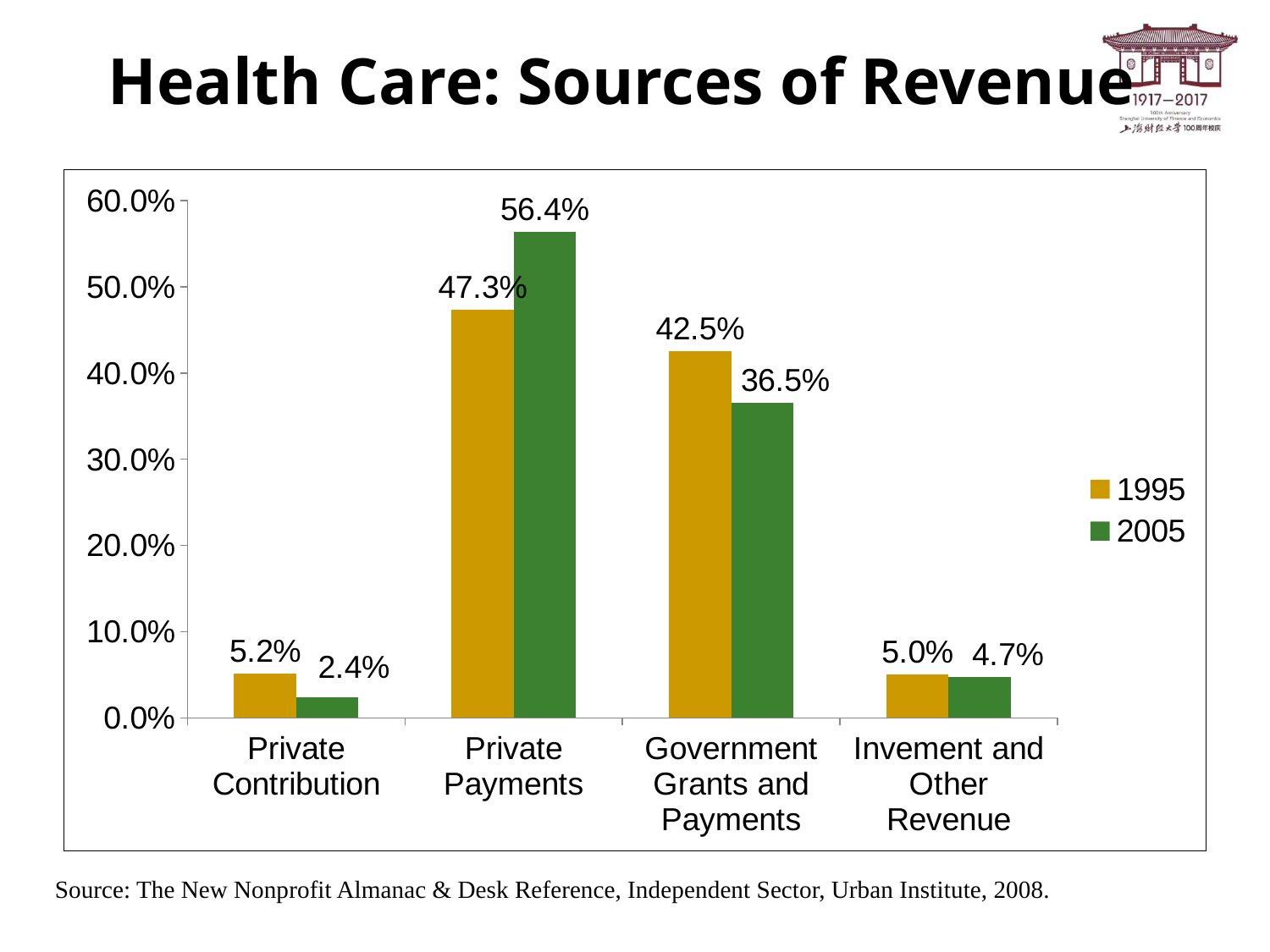
How many series does the legend list? 2 What is the difference between the 2005 and 1995 values for Private Payments? 9.1% What is the 1995 value for Private Payments? 47.3% Is the 1995 value for Government Grants and Payments greater or less than 40.0%? greater What is the 2005 value for Government Grants and Payments? 36.5% Which category has the highest 2005 value? Private Payments Which colour represents the 2005 series in the legend? Green What is the 2005 value for Private Contribution? 2.4% Which is larger for Government Grants and Payments, the 1995 value or the 2005 value? 1995 How many categories are shown on the x axis? 4 Which category has the lowest 1995 value? Invement and Other Revenue What kind of chart is shown on the slide? Bar chart